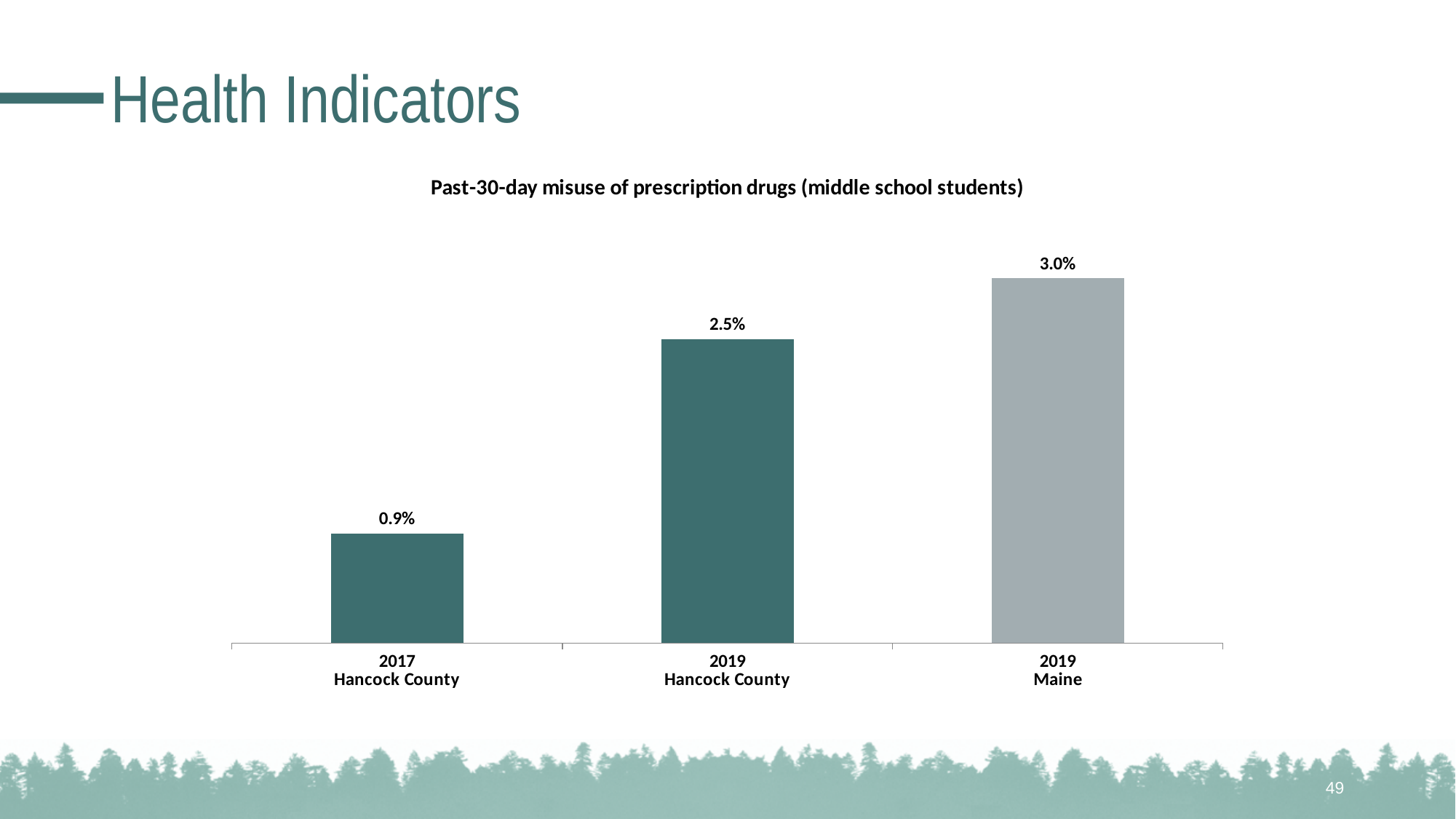
Do the values rise or fall from left to right across the chart? Rise What is the value for 2019 Hancock County? 2.5% What kind of chart is shown on the slide? Bar chart What is the title of the chart? Past-30-day misuse of prescription drugs (middle school students) What is the value for 2019 Maine? 3.0% What is the difference between the 2019 Maine value and the 2019 Hancock County value? 0.5% What is the difference between the 2019 Hancock County value and the 2017 Hancock County value? 1.6% How many bars are shown in the chart? 3 Which is larger, the value for 2019 Hancock County or the value for 2019 Maine? 2019 Maine Which category has the highest value? 2019 Maine What is the value for 2017 Hancock County? 0.9% Which category has the lowest value? 2017 Hancock County